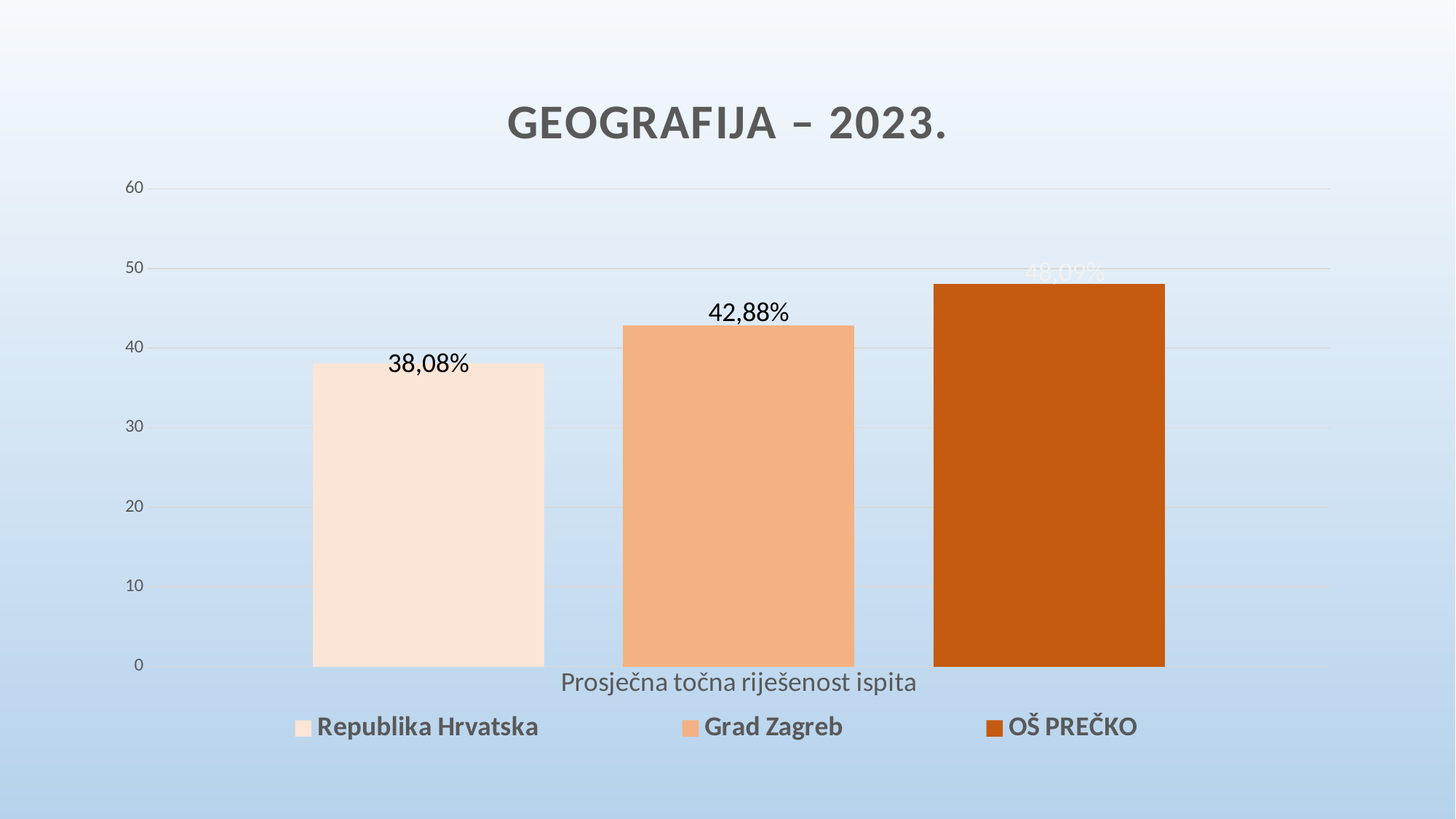
How many series does the legend list? 3 What is the difference between the values for Grad Zagreb and Republika Hrvatska? 4,80% What is the value for Republika Hrvatska? 38,08% Which series has the lowest value? Republika Hrvatska What is the difference between the values for OŠ PREČKO and Grad Zagreb? 5,21% Is the value for OŠ PREČKO greater or less than 50? less What is the value for OŠ PREČKO? 48,09% What is the title of the chart? GEOGRAFIJA – 2023. What kind of chart is shown on the slide? bar chart Which series has the highest value? OŠ PREČKO What is the value for Grad Zagreb? 42,88% Which is larger, the value for Grad Zagreb or the value for Republika Hrvatska? Grad Zagreb